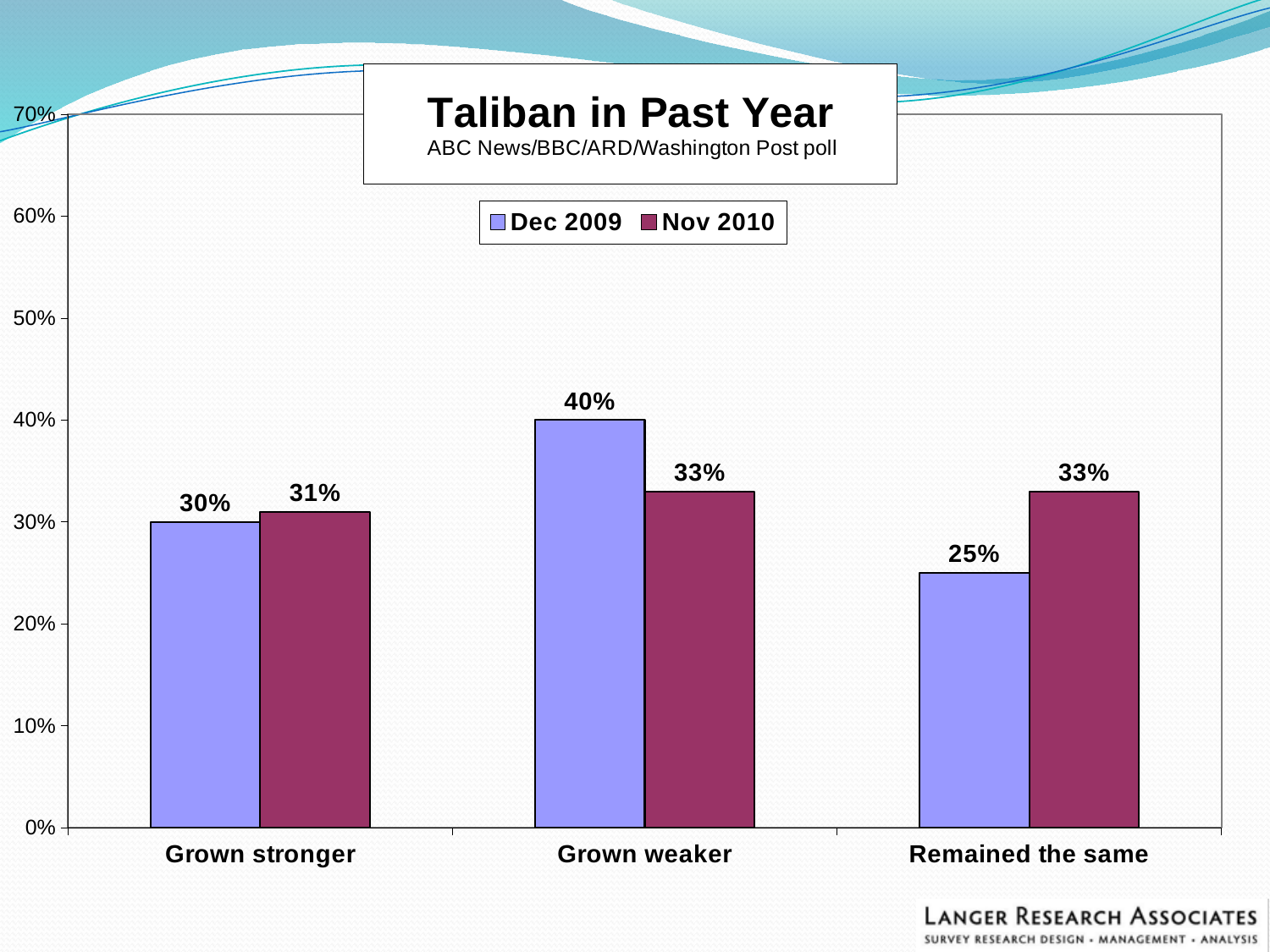
What is the Nov 2010 value for Remained the same? 33% What is the difference between the Dec 2009 and Nov 2010 values for Grown weaker? 7% Which category has the lowest Dec 2009 value? Remained the same What is the difference between the Dec 2009 and Nov 2010 values for Remained the same? 8% What kind of chart is shown on the slide? Bar chart Which is larger for Remained the same: the Dec 2009 value or the Nov 2010 value? Nov 2010 How many categories are shown on the x axis? 3 What is the Dec 2009 value for Grown weaker? 40% What is the Dec 2009 value for Grown stronger? 30% How many series does the legend list? 2 Which category has the lowest Nov 2010 value? Grown stronger Which category has the highest Dec 2009 value? Grown weaker